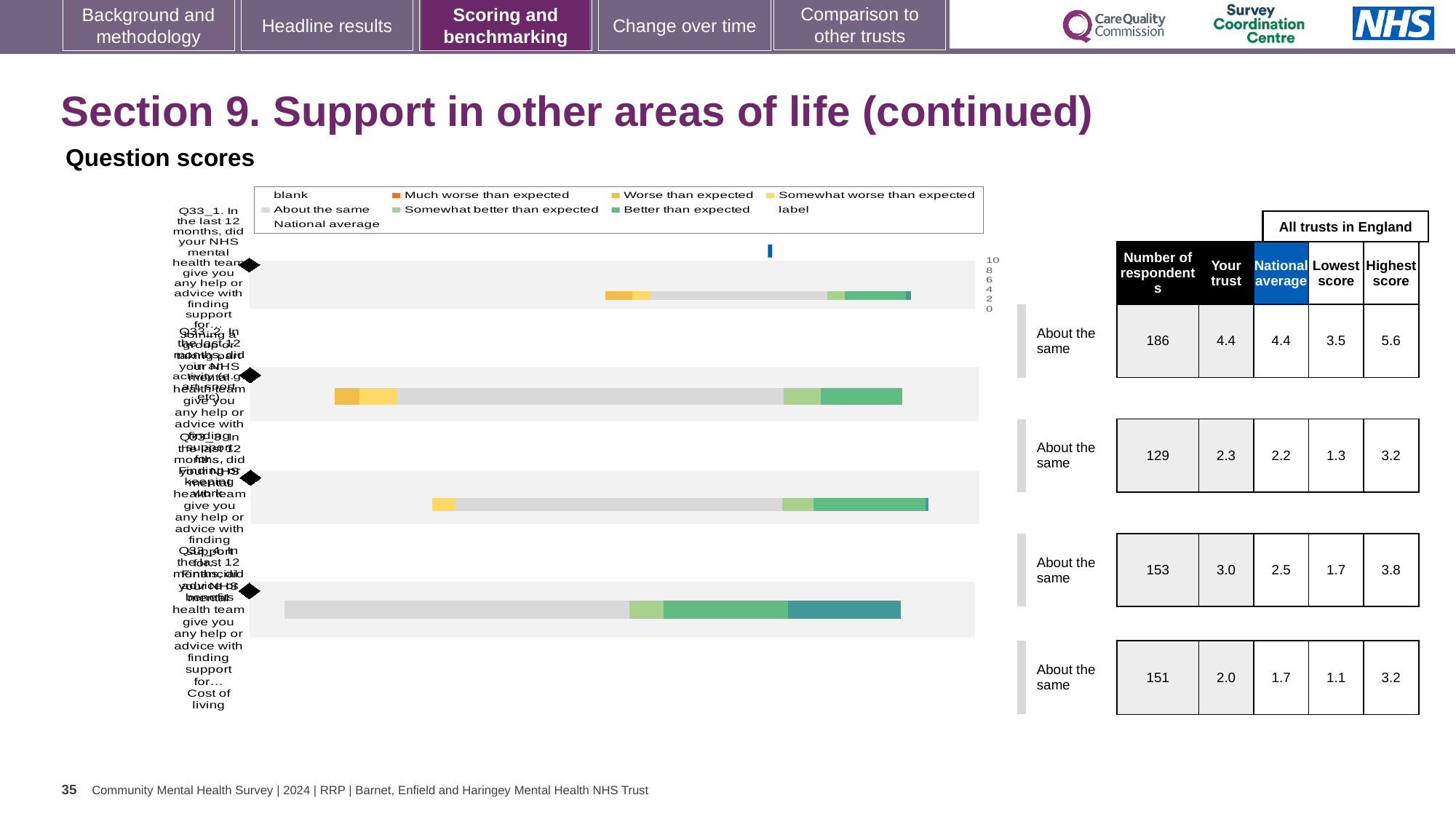
Which question row has the lowest number of respondents in the table? second row, 129 In the table, what is the national average for the second question row? 2.2 In the table, what is the 'Your trust' score for the fourth question row? 2.0 In the table, what is the 'Your trust' score for the first question (Q33_1)? 4.4 In the table, what is the number of respondents for the first question (Q33_1)? 186 Which question row has the highest number of respondents in the table? Q33_1 (first row), 186 How many question bars are plotted in the chart? 4 In the table, what is the lowest score for the third question row? 1.7 For the fourth question row, which is larger: the 'Your trust' score or the national average? Your trust (2.0) In the table, what is the highest score across all trusts in England for the first question (Q33_1)? 5.6 What kind of chart is shown on the slide? bar chart For the third question row, what is the difference between the 'Your trust' score and the national average? 0.5